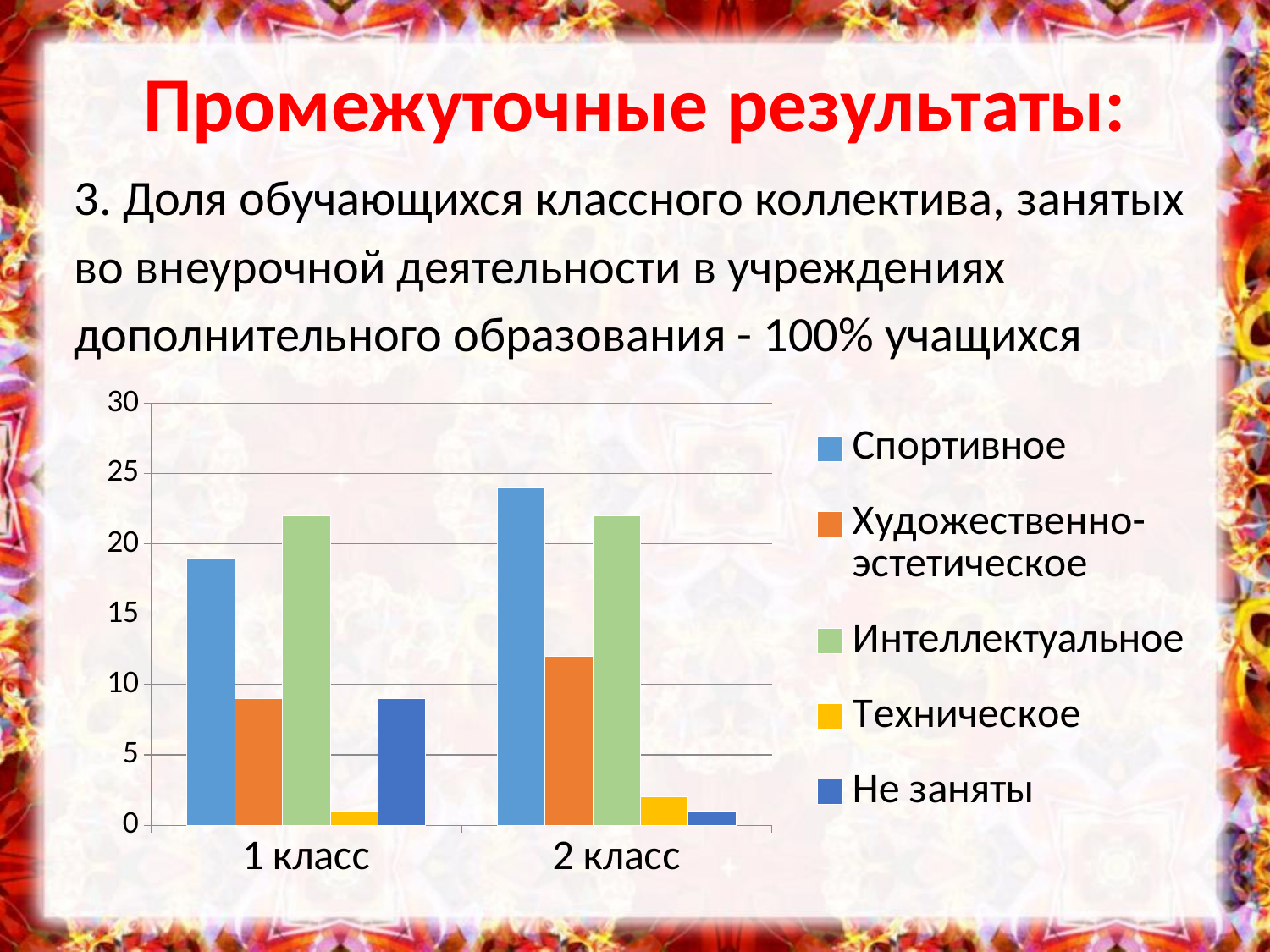
How many series does the legend list? 5 Is the value for Не заняты in 2 класс greater or less than 5? less Which series has the highest bar for 1 класс? Интеллектуальное Does the value for Не заняты rise or fall from 1 класс to 2 класс? fall Is the value for Спортивное in 1 класс greater or less than 15? greater Is the value for Спортивное in 2 класс greater or less than 20? greater Which is larger: Спортивное in 1 класс or Спортивное in 2 класс? Спортивное in 2 класс What kind of chart is shown on the slide? bar chart Which series has the lowest bar for 1 класс? Техническое How many categories are shown on the x axis? 2 Which series has the highest bar for 2 класс? Спортивное